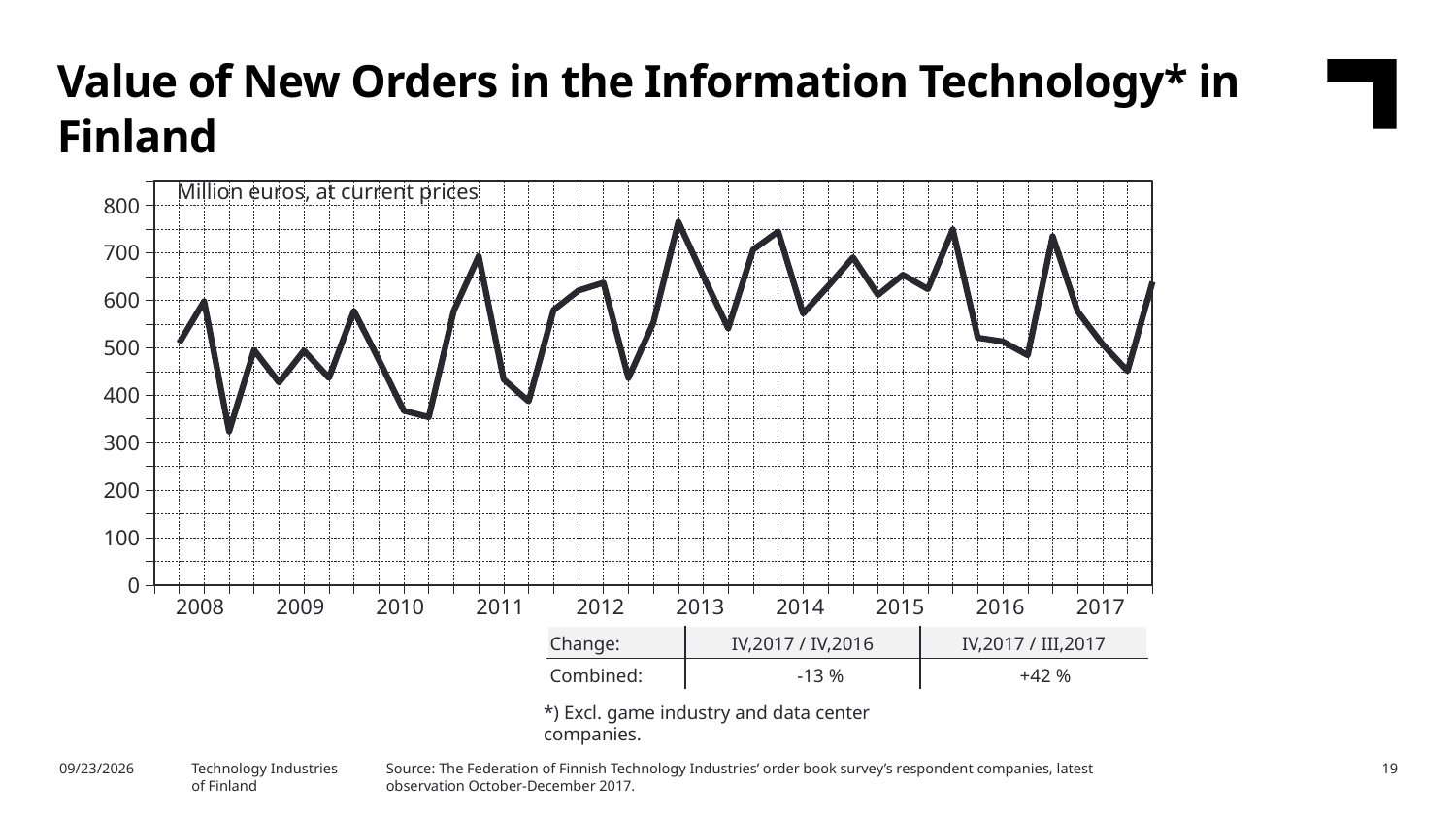
In what unit are the values on the chart expressed, according to the label inside the plot area? Million euros, at current prices What is the combined change for IV,2017 compared with III,2017 shown in the table below the chart? +42 % Is the value at the last point of the line (end of 2017) greater or less than 600? greater What is the combined change for IV,2017 compared with IV,2016 shown in the table below the chart? -13 % Does the line rise or fall between the last two points of 2017? rise What is the title of the chart on the slide? Value of New Orders in the Information Technology* in Finland Is the highest value reached in 2012 greater or less than 700? less Is the highest value reached in 2016 greater or less than 700? greater How many years are labelled on the x axis of the chart? 10 What kind of chart is shown on the slide? line chart